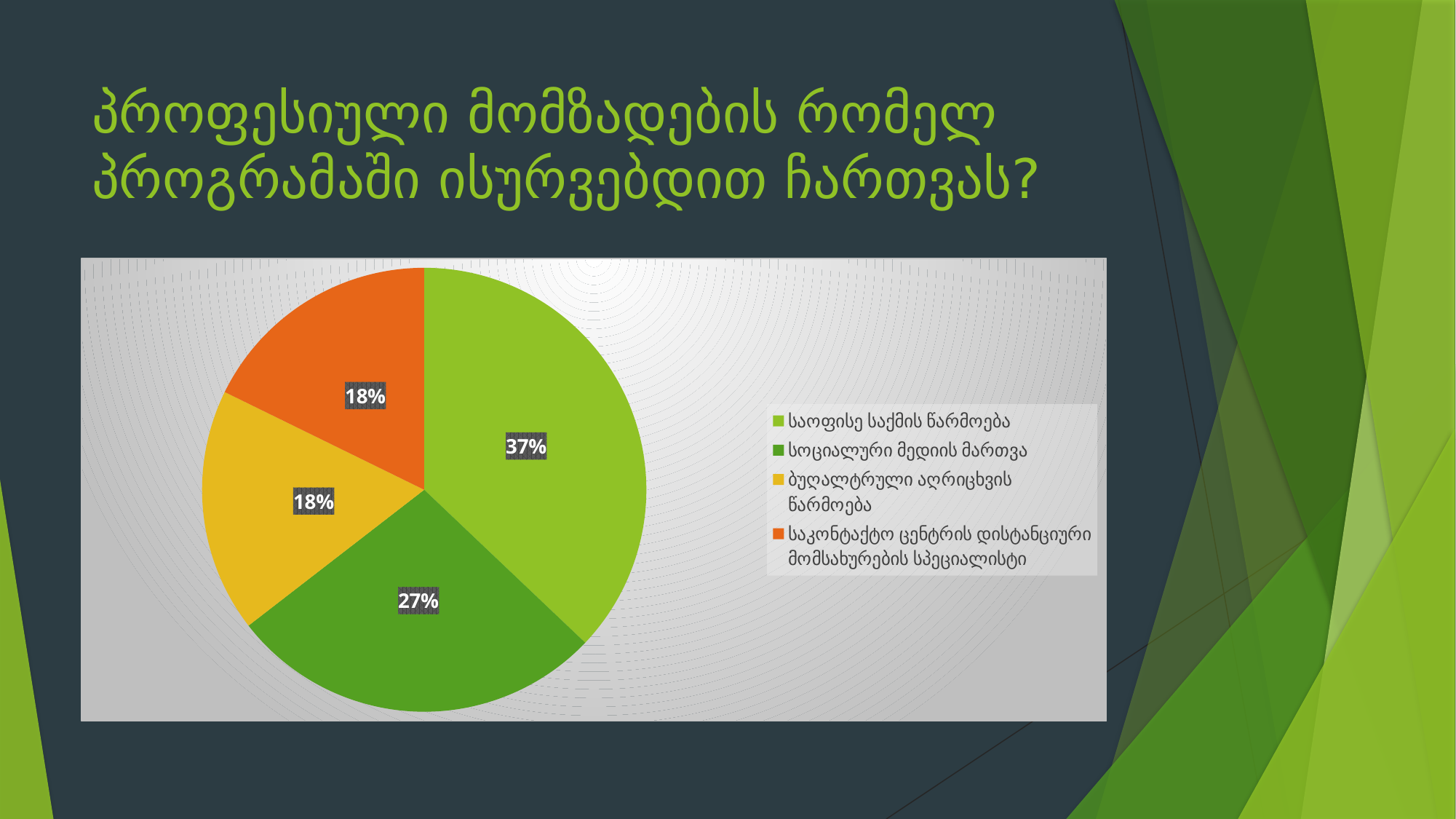
What share of the pie does "ბუღალტრული აღრიცხვის წარმოება" have? 18% What share of the pie does "საკონტაქტო ცენტრის დისტანციური მომსახურების სპეციალისტი" have? 18% What share of the pie does "სოციალური მედიის მართვა" have? 27% What colour is the slice for "საკონტაქტო ცენტრის დისტანციური მომსახურების სპეციალისტი"? Orange What is the title of the slide above the chart? პროფესიული მომზადების რომელ პროგრამაში ისურვებდით ჩართვას? What is the difference in percentage points between "საოფისე საქმის წარმოება" and "სოციალური მედიის მართვა"? 10 percentage points What type of chart is shown on the slide? Pie chart Which category has the largest slice of the pie? საოფისე საქმის წარმოება How many entries does the legend list? 4 What share of the pie does "საოფისე საქმის წარმოება" have? 37% Which is larger: the share for "სოციალური მედიის მართვა" or the share for "ბუღალტრული აღრიცხვის წარმოება"? სოციალური მედიის მართვა How many slices does the pie chart have? 4